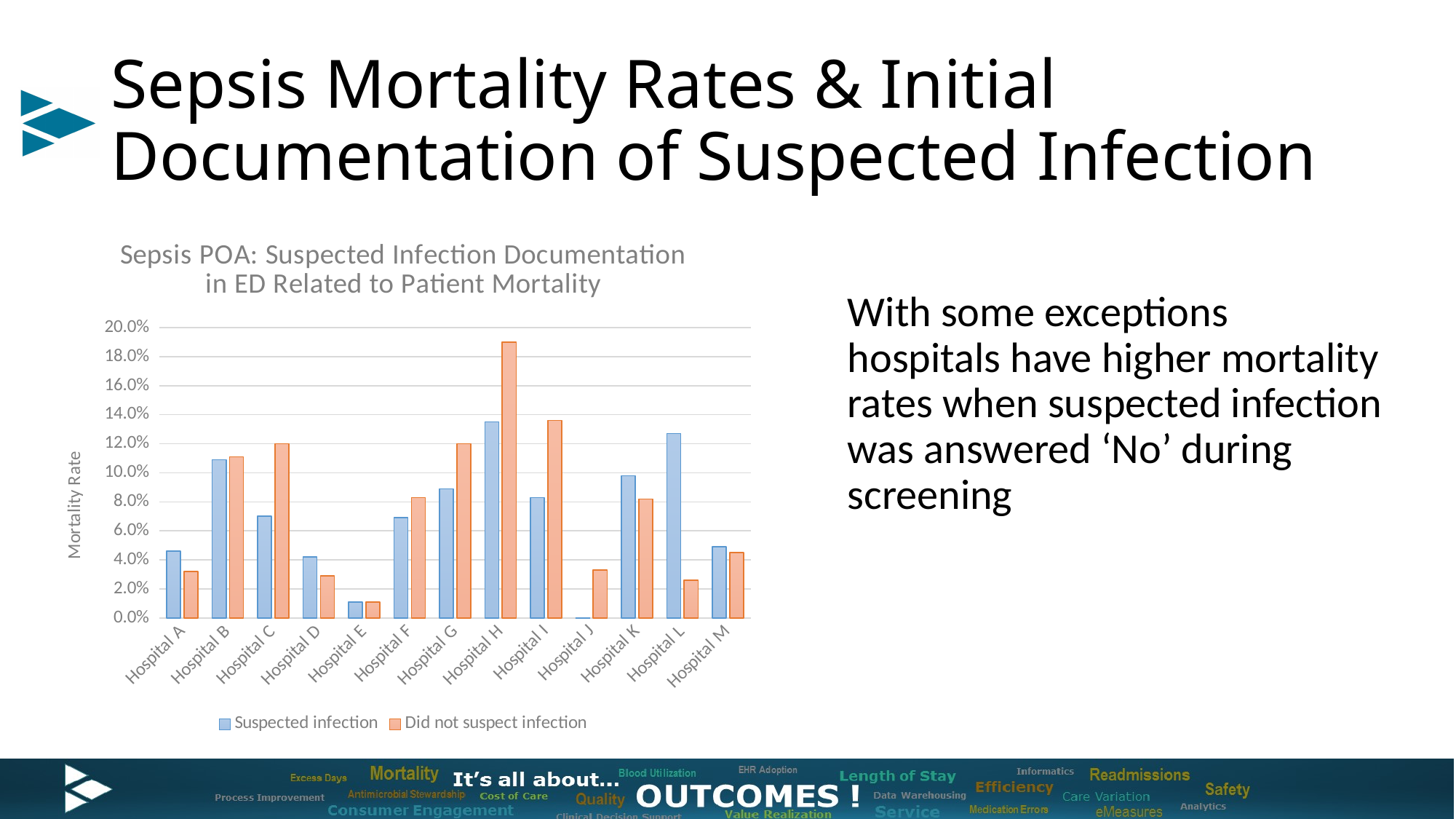
How many hospitals are shown on the x axis of the chart? 13 What is the label on the vertical axis of the chart? Mortality Rate Which hospital has the lowest 'Suspected infection' mortality rate? Hospital J Which hospital has the highest 'Did not suspect infection' mortality rate? Hospital H For Hospital L, which is larger: the 'Suspected infection' rate or the 'Did not suspect infection' rate? Suspected infection For Hospital I, which is larger: the 'Suspected infection' rate or the 'Did not suspect infection' rate? Did not suspect infection Is the 'Suspected infection' value for Hospital E greater or less than 2.0%? less Which colour represents the 'Did not suspect infection' series in the chart? Orange Is the 'Did not suspect infection' value for Hospital H greater or less than 18.0%? greater Is the 'Did not suspect infection' value for Hospital C greater or less than 10.0%? greater How many series does the chart legend list? 2 What kind of chart is shown on the slide? bar chart